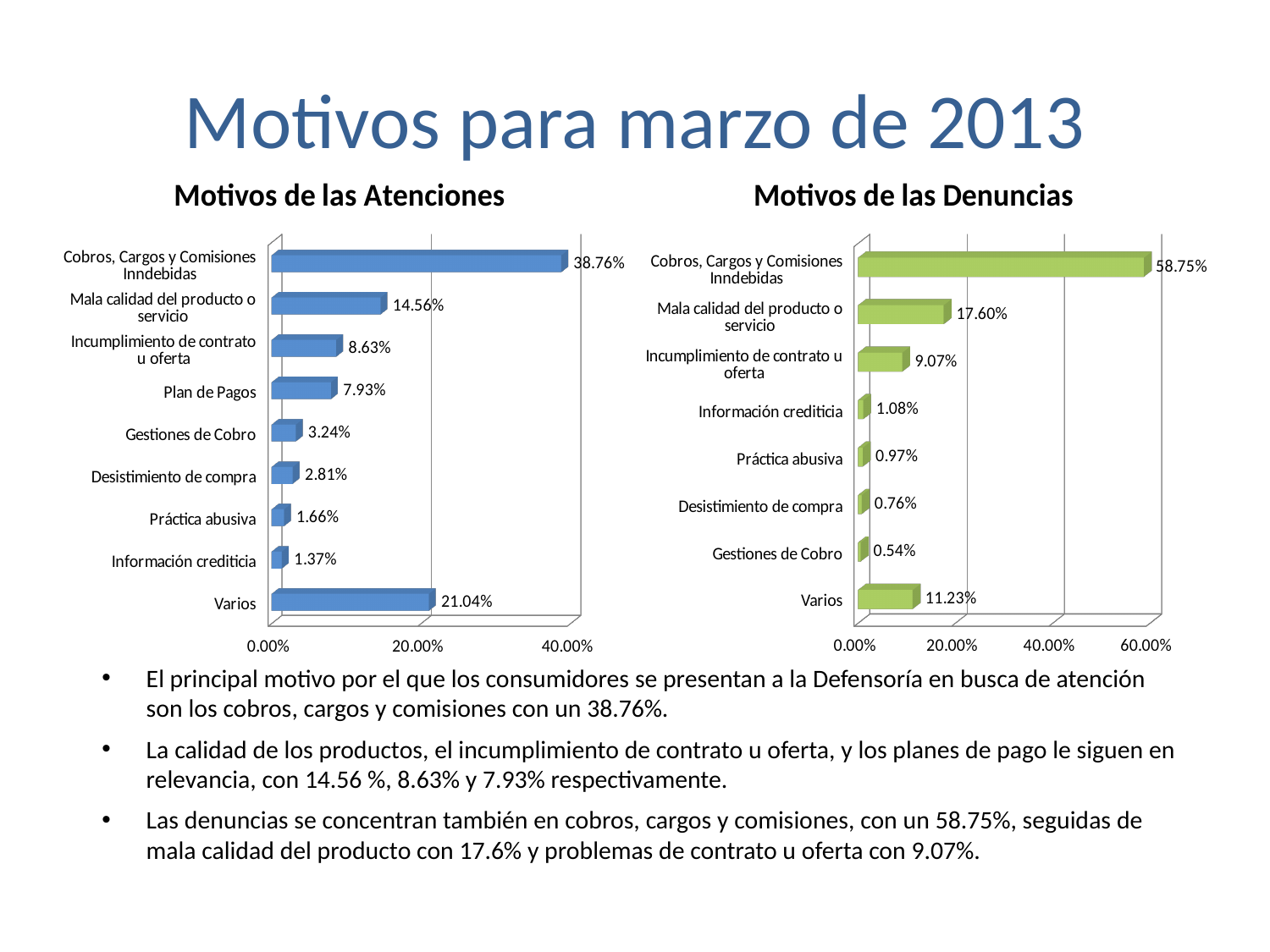
In the 'Motivos de las Denuncias' chart, which category has the lowest value? Gestiones de Cobro In the 'Motivos de las Denuncias' chart, what is the value for Mala calidad del producto o servicio? 17.60% In the 'Motivos de las Denuncias' chart, which is larger: Varios or Incumplimiento de contrato u oferta? Varios In the 'Motivos de las Atenciones' chart, which category has the lowest value? Información crediticia In the 'Motivos de las Atenciones' chart, what is the value for Plan de Pagos? 7.93% What colour are the bars in the 'Motivos de las Denuncias' chart? Green In the 'Motivos de las Denuncias' chart, what is the difference between Cobros, Cargos y Comisiones Inndebidas and Mala calidad del producto o servicio? 41.15% How many categories are shown in the 'Motivos de las Denuncias' chart? 8 What kind of chart is 'Motivos de las Atenciones'? Bar chart In the 'Motivos de las Atenciones' chart, what is the difference between Cobros, Cargos y Comisiones Inndebidas and Varios? 17.72% In the 'Motivos de las Atenciones' chart, which is larger: Gestiones de Cobro or Desistimiento de compra? Gestiones de Cobro In the 'Motivos de las Atenciones' chart, which category has the highest value? Cobros, Cargos y Comisiones Inndebidas